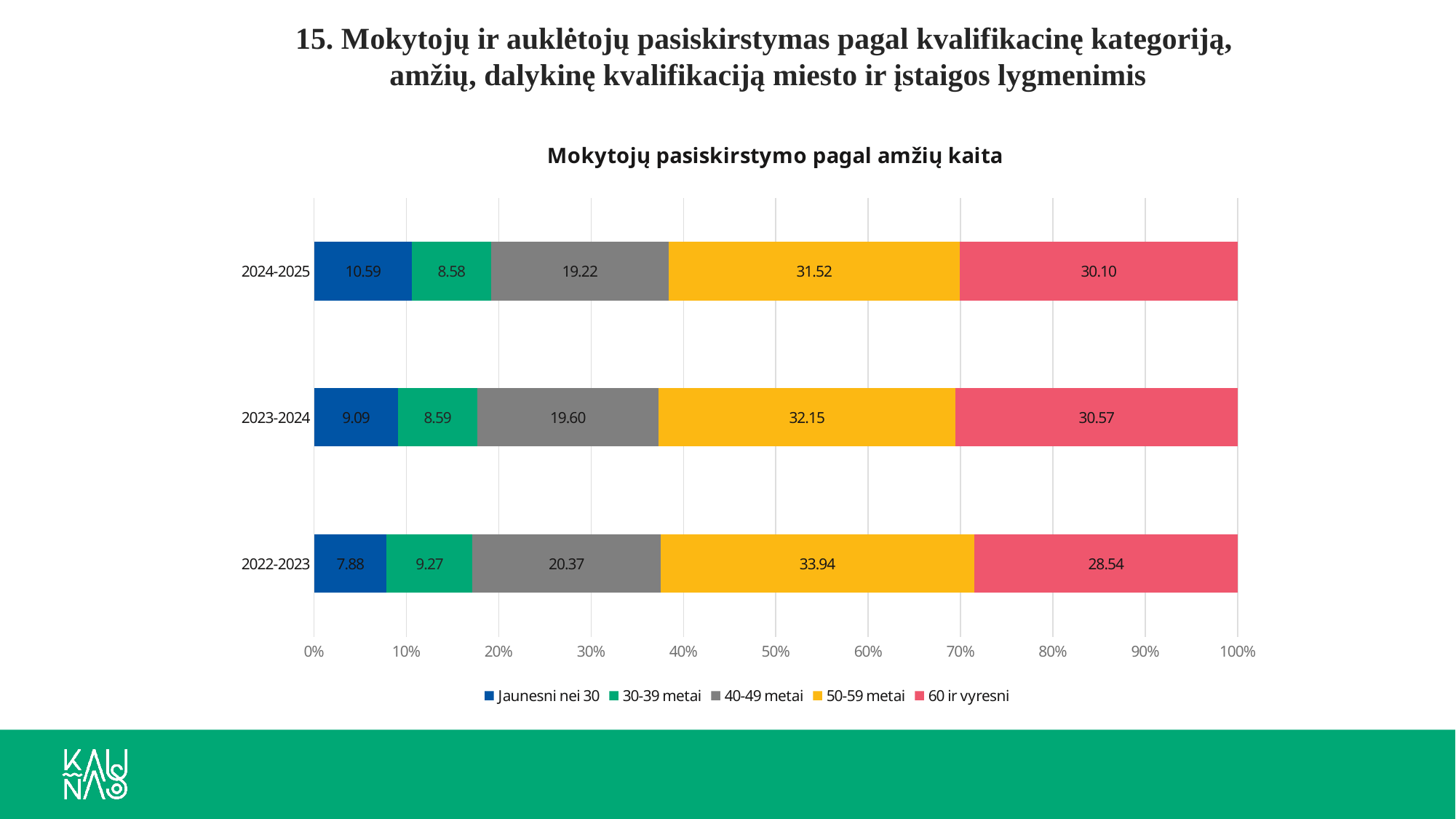
How many series does the legend list? 5 Which is larger: the 'Jaunesni nei 30' value in 2022-2023 or in 2023-2024? 2023-2024 How many school years are shown on the chart? 3 What kind of chart is shown? Stacked bar chart What is the value for 'Jaunesni nei 30' in 2024-2025? 10.59 What is the value for '50-59 metai' in 2022-2023? 33.94 In which school year is the '60 ir vyresni' share the lowest? 2022-2023 What is the difference between the '40-49 metai' and '30-39 metai' values in 2022-2023? 11.10 In which school year is the 'Jaunesni nei 30' share the highest? 2024-2025 What is the difference between the '50-59 metai' and '60 ir vyresni' values in 2024-2025? 1.42 What is the value for '60 ir vyresni' in 2023-2024? 30.57 Does the '50-59 metai' share rise or fall from 2022-2023 to 2024-2025? Fall